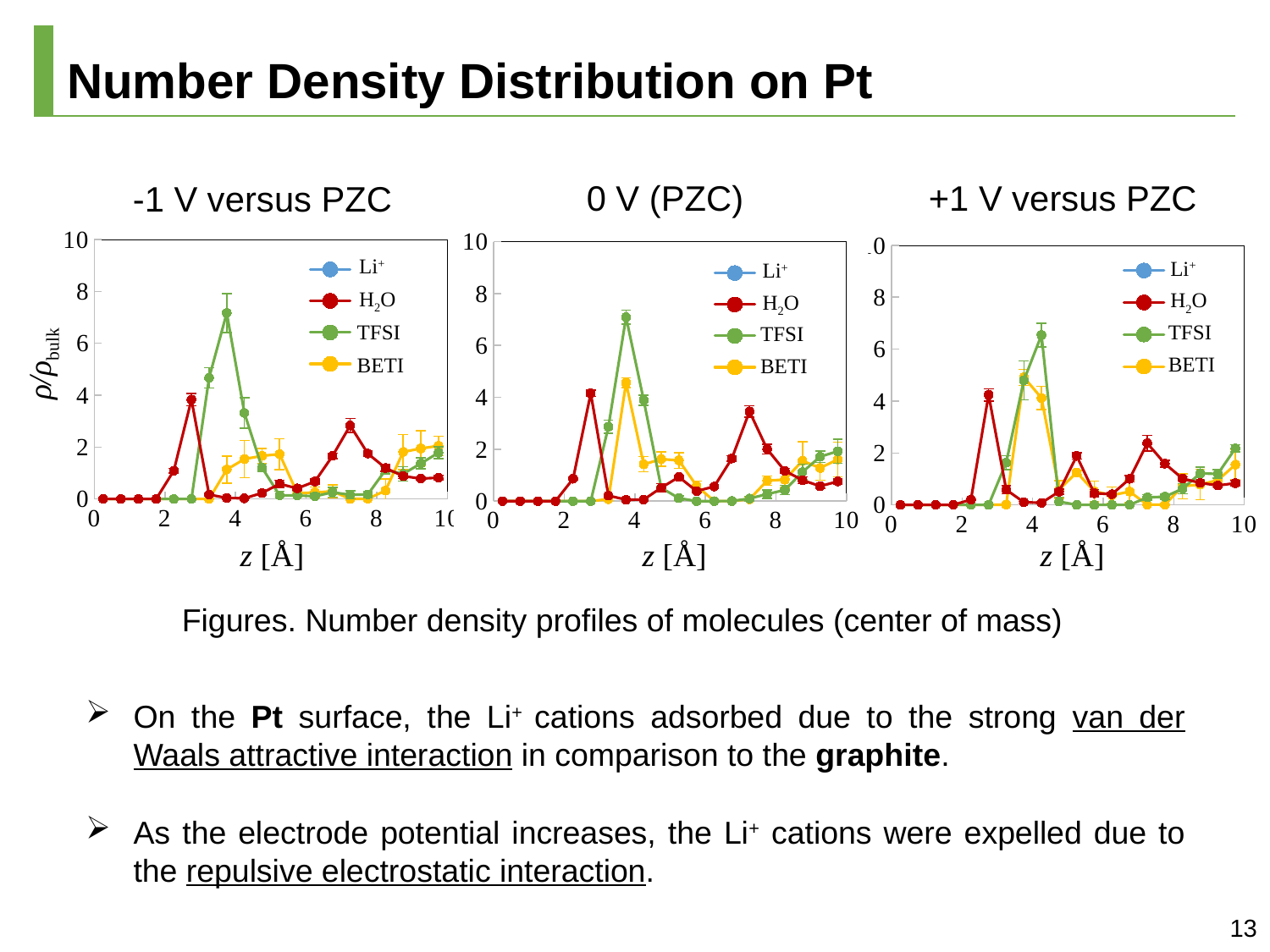
What kind of chart is the "-1 V versus PZC" chart? line chart In the "+1 V versus PZC" chart, which series has the larger peak value, TFSI or H2O? TFSI In the "-1 V versus PZC" chart, is the peak value of TFSI greater or less than 6? greater Which series are listed in the legend of the "+1 V versus PZC" chart? Li+, H2O, TFSI, BETI In the "0 V (PZC)" chart, which series has the larger peak value, TFSI or BETI? TFSI What is the label of the x axis on the charts? z [Å] In the "0 V (PZC)" chart, is the peak value of H2O near z = 3 Å greater or less than 6? less In the "-1 V versus PZC" chart, which series reaches the highest peak value? TFSI How many series does the legend of the "0 V (PZC)" chart list? 4 How many charts are shown on the slide? 3 In the "+1 V versus PZC" chart, is the peak value of TFSI greater or less than 4? greater